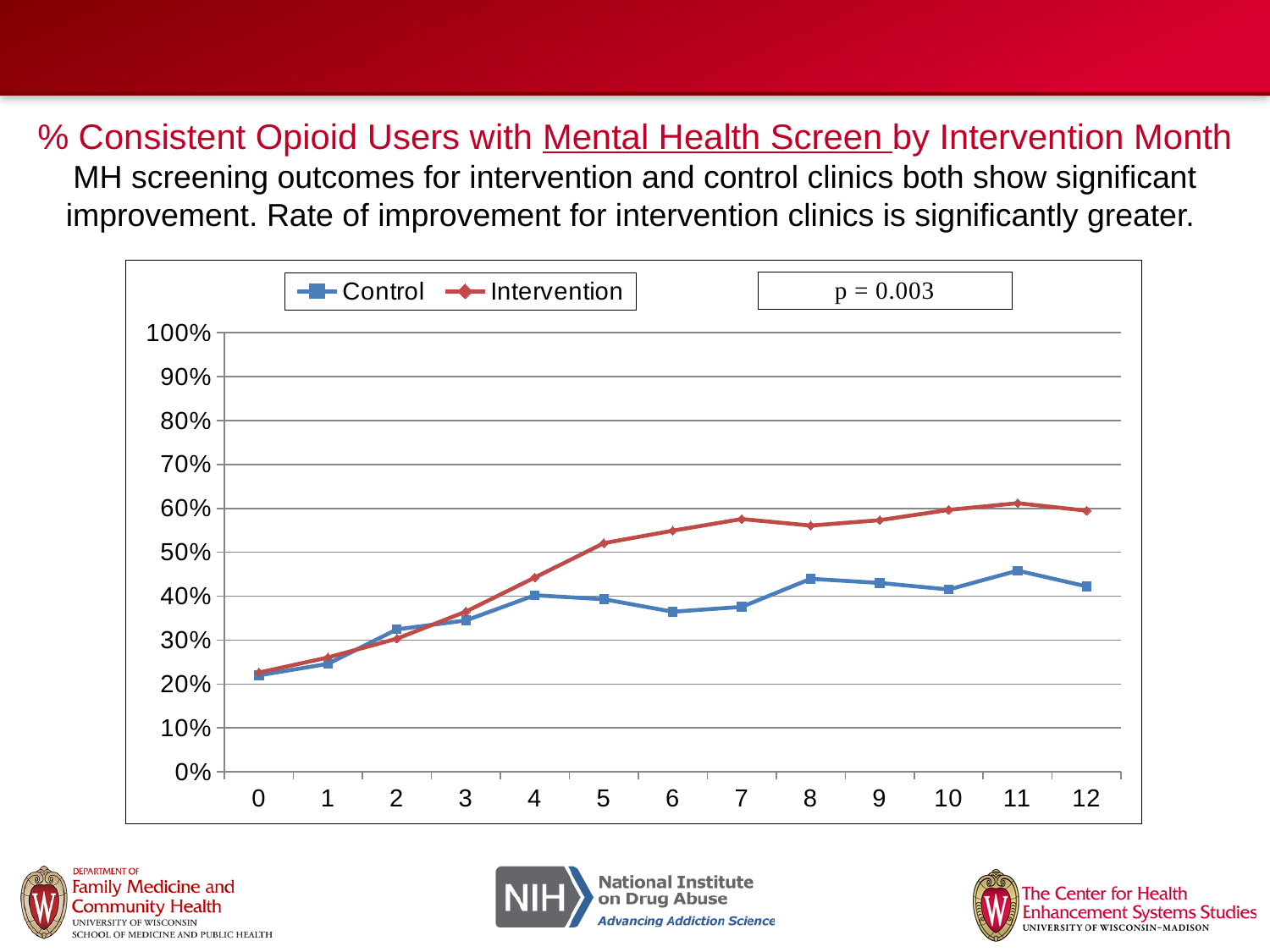
At month 12, which series has the higher value, Control or Intervention? Intervention Is the Intervention value at month 12 greater or less than 50%? greater What p-value is shown in the box on the chart? p = 0.003 How many series does the chart's legend list? 2 What colour is the Intervention line in the chart? red Is the Control value at month 0 greater or less than 30%? less Is the Control value at month 12 greater or less than 50%? less Overall, does the Intervention series rise or fall from month 0 to month 12? rise How many intervention months (x-axis points) are plotted on the chart? 13 What kind of chart is shown on the slide? line chart At which month does the Intervention series reach its highest value? 11